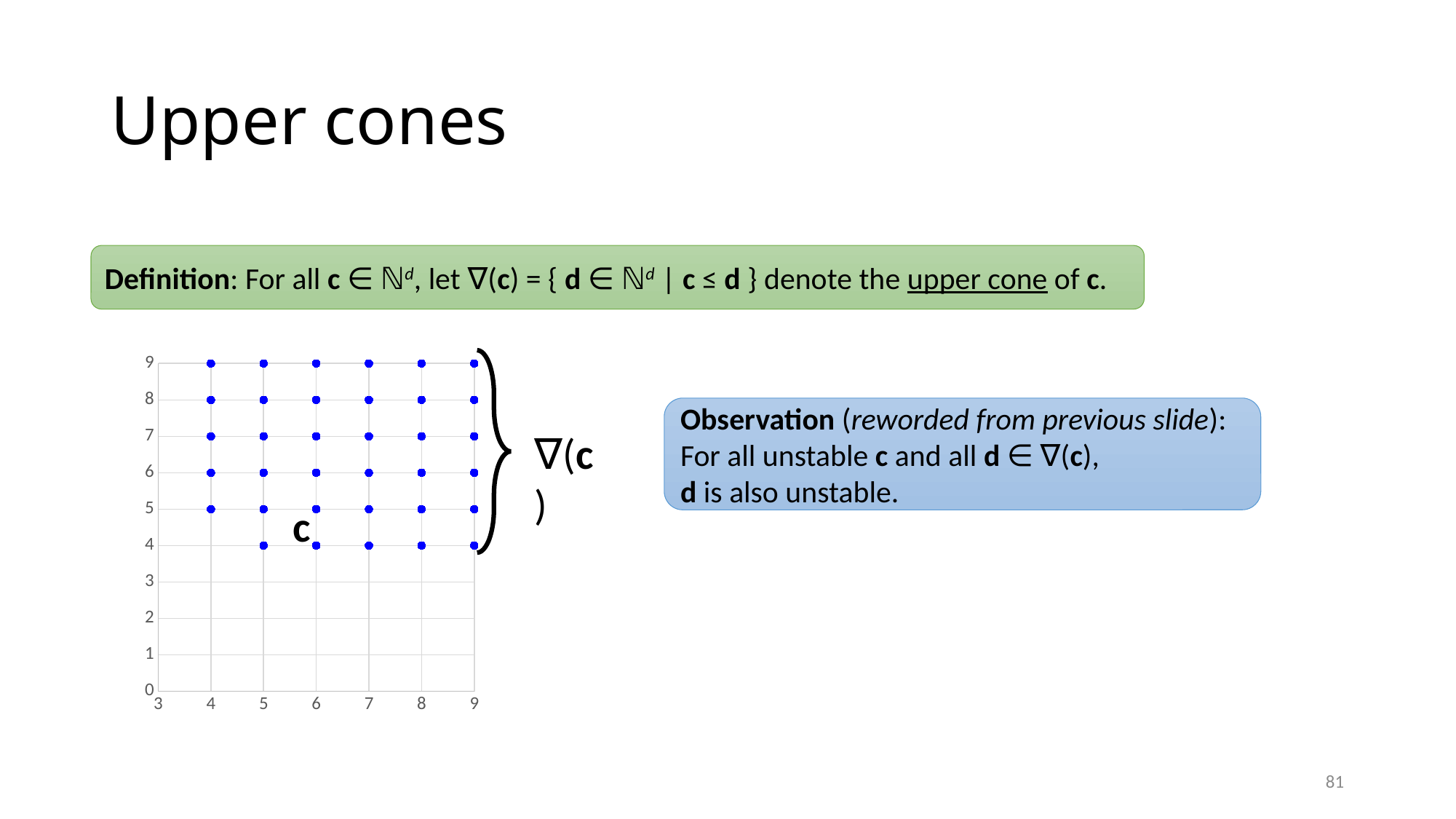
What is the highest value shown on the y axis of the chart? 9 How many points are plotted in the row at y = 9? 6 What is the smallest x value at which any point is plotted? 4 Is there any point plotted at y = 3 on the chart? No How many points are plotted in total on the chart? 35 What is the largest x value at which any point is plotted? 9 How many rows of points are plotted on the chart? 6 What is the lowest value shown on the x axis of the chart? 3 What is the smallest y value at which any point is plotted? 4 What kind of chart is shown on the slide? scatter chart